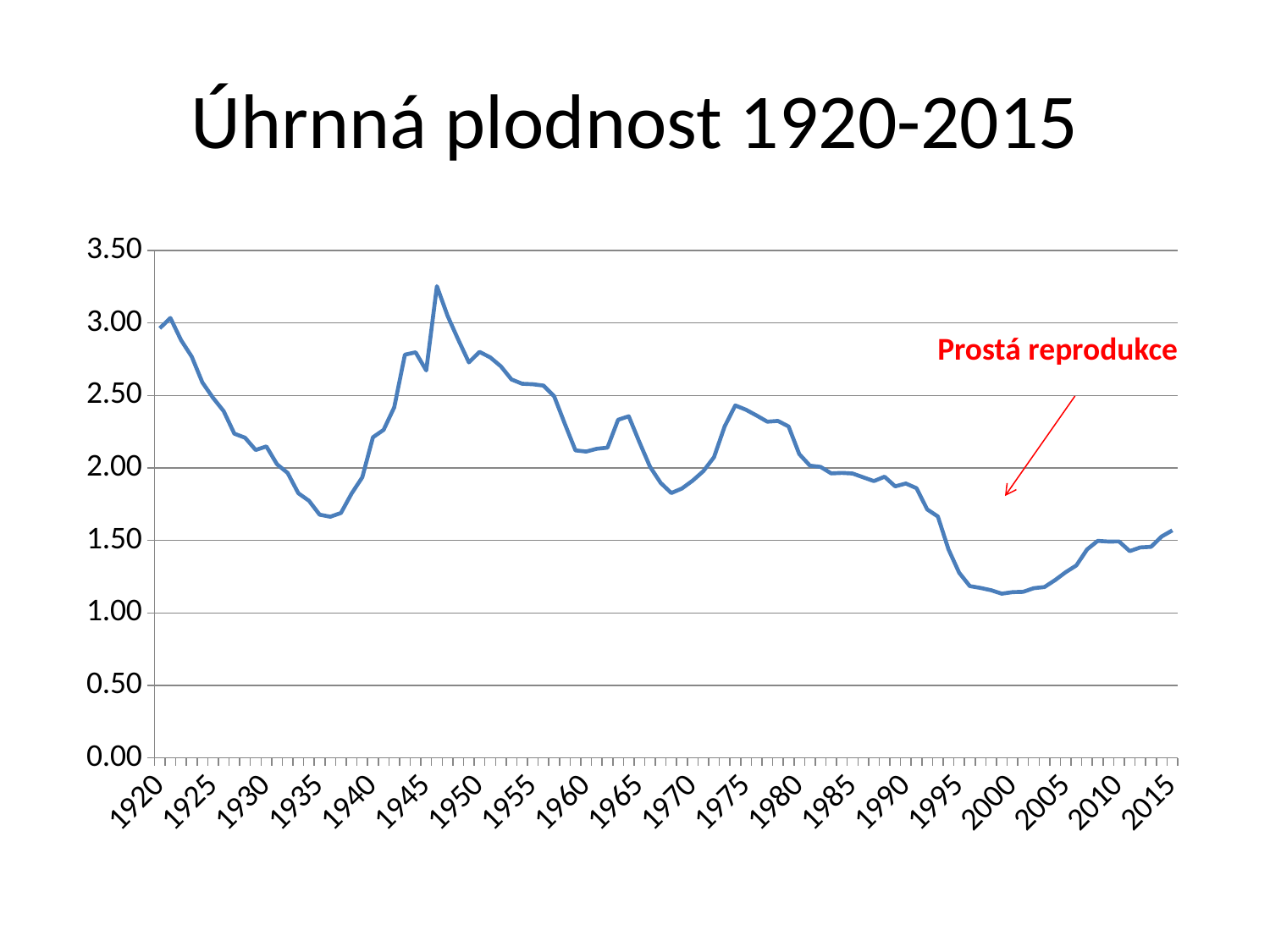
Is the value for 1935 greater or less than 2.00? less Is the highest value on the chart greater or less than 3.00? greater Which year has the larger value, 1920 or 2015? 1920 Do the values rise or fall between 2000 and 2015? rise What is the title of the chart? Úhrnná plodnost 1920-2015 Is the value for 1945 greater or less than 2.50? greater Do the values rise or fall between 1920 and 1935? fall What does the red annotation on the chart say? Prostá reprodukce What kind of chart is shown on the slide? line chart